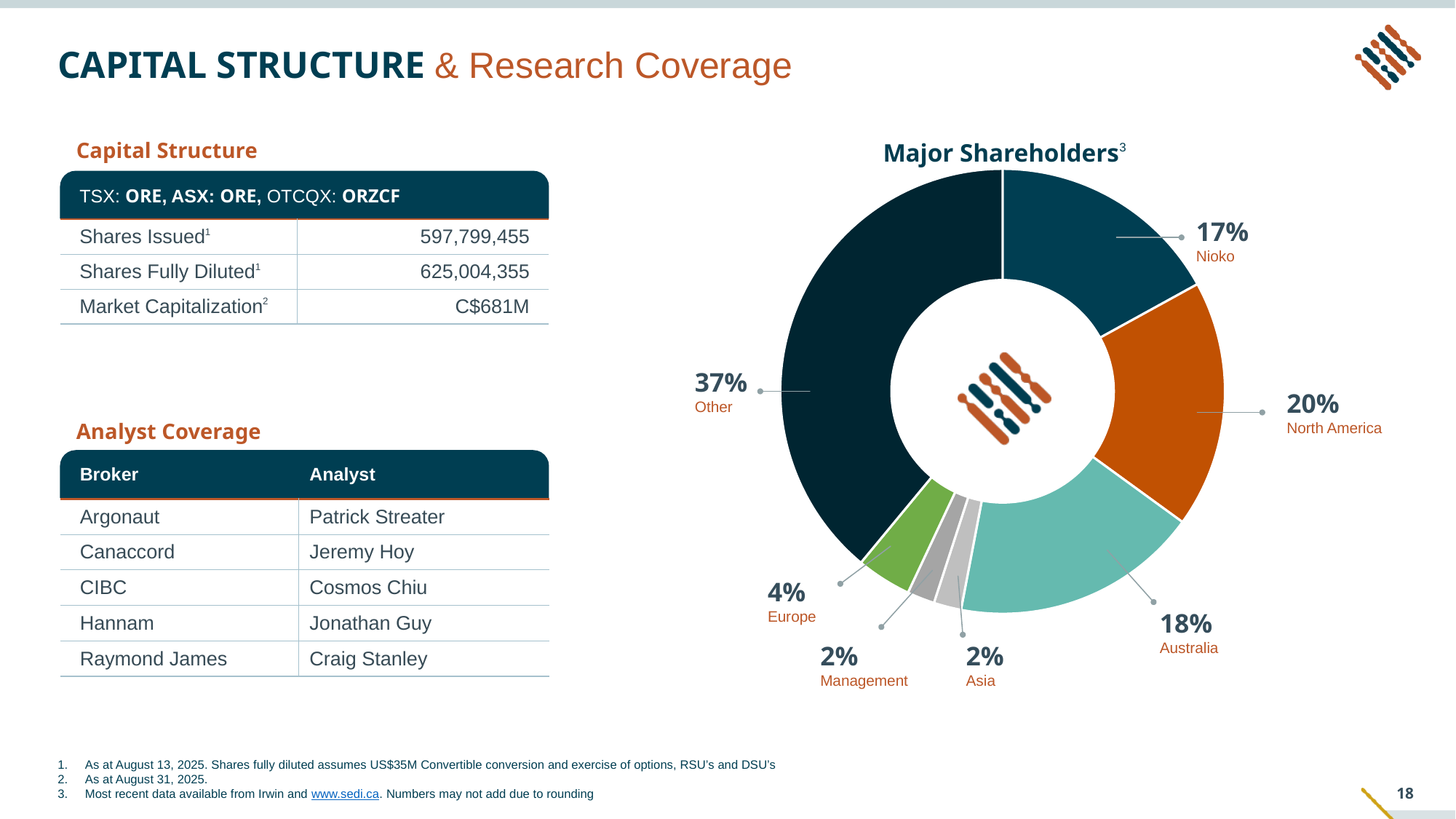
What kind of chart is the Major Shareholders chart? Pie chart (donut) Which category has the largest share in the Major Shareholders chart? Other What share of the Major Shareholders chart is Australia? 18% Which is larger in the Major Shareholders chart, North America or Australia? North America What is the difference in percentage points between the Other and Nioko shares in the Major Shareholders chart? 20 What is the title of the chart on the slide? Major Shareholders How many categories are shown in the Major Shareholders chart? 7 What share of the Major Shareholders chart is North America? 20% What is the combined share of Management and Asia in the Major Shareholders chart? 4% What share of the Major Shareholders chart is Europe? 4% What share of the Major Shareholders chart is held by Nioko? 17% Which category has the smallest share in the Major Shareholders chart, Europe or Asia? Asia